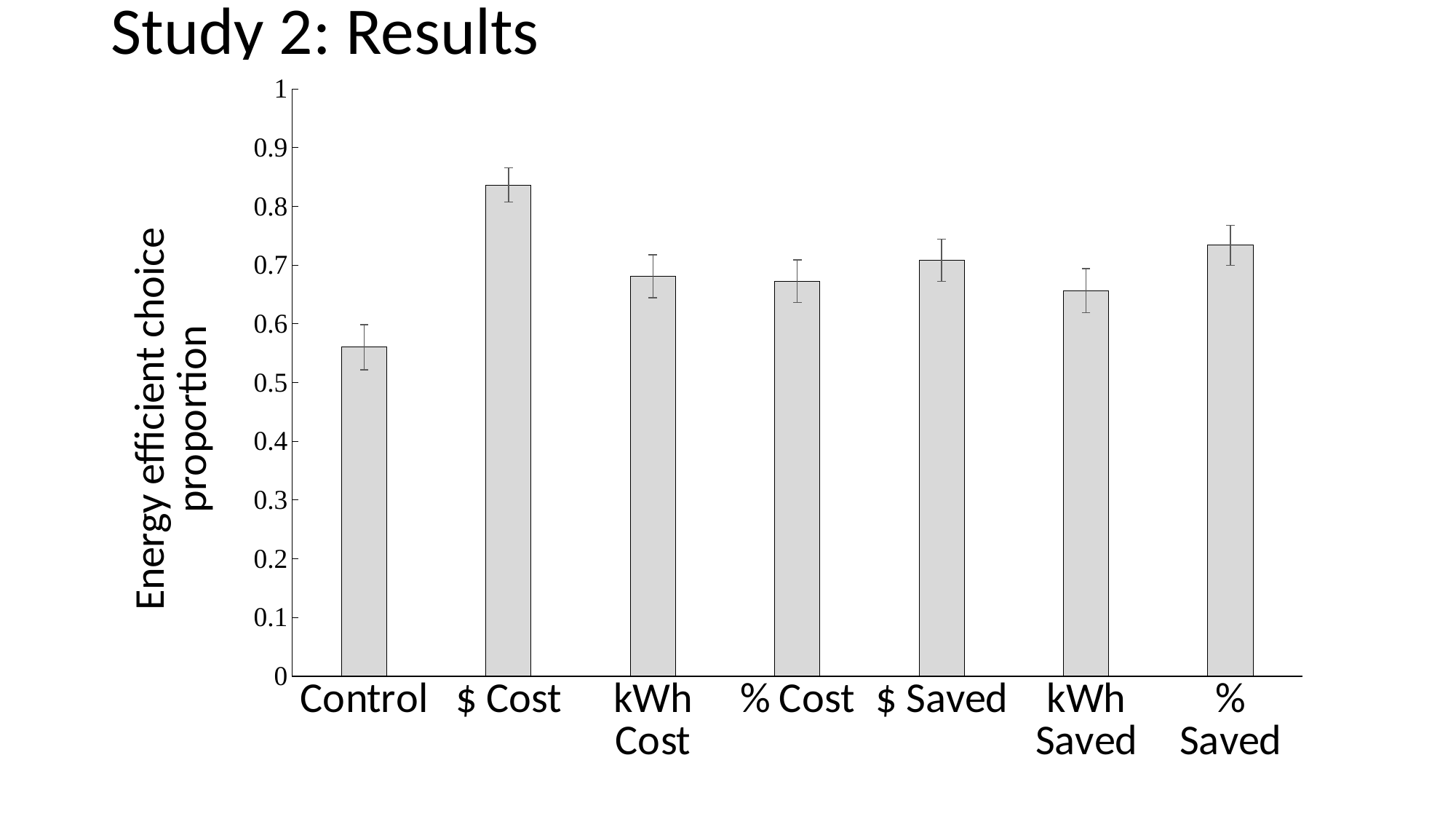
Which is larger, the value for $ Cost or the value for % Saved? $ Cost Is the value for % Saved greater or less than 0.7? greater What kind of chart is shown on the slide? bar chart What is the label of the y axis? Energy efficient choice proportion Is the value for kWh Saved greater or less than 0.7? less Which is larger, the value for Control or the value for kWh Saved? kWh Saved Is the value for Control greater or less than 0.6? less What is the title of the slide? Study 2: Results How many categories are plotted on the x axis? 7 Which category has the lowest energy efficient choice proportion? Control Which category has the highest energy efficient choice proportion? $ Cost